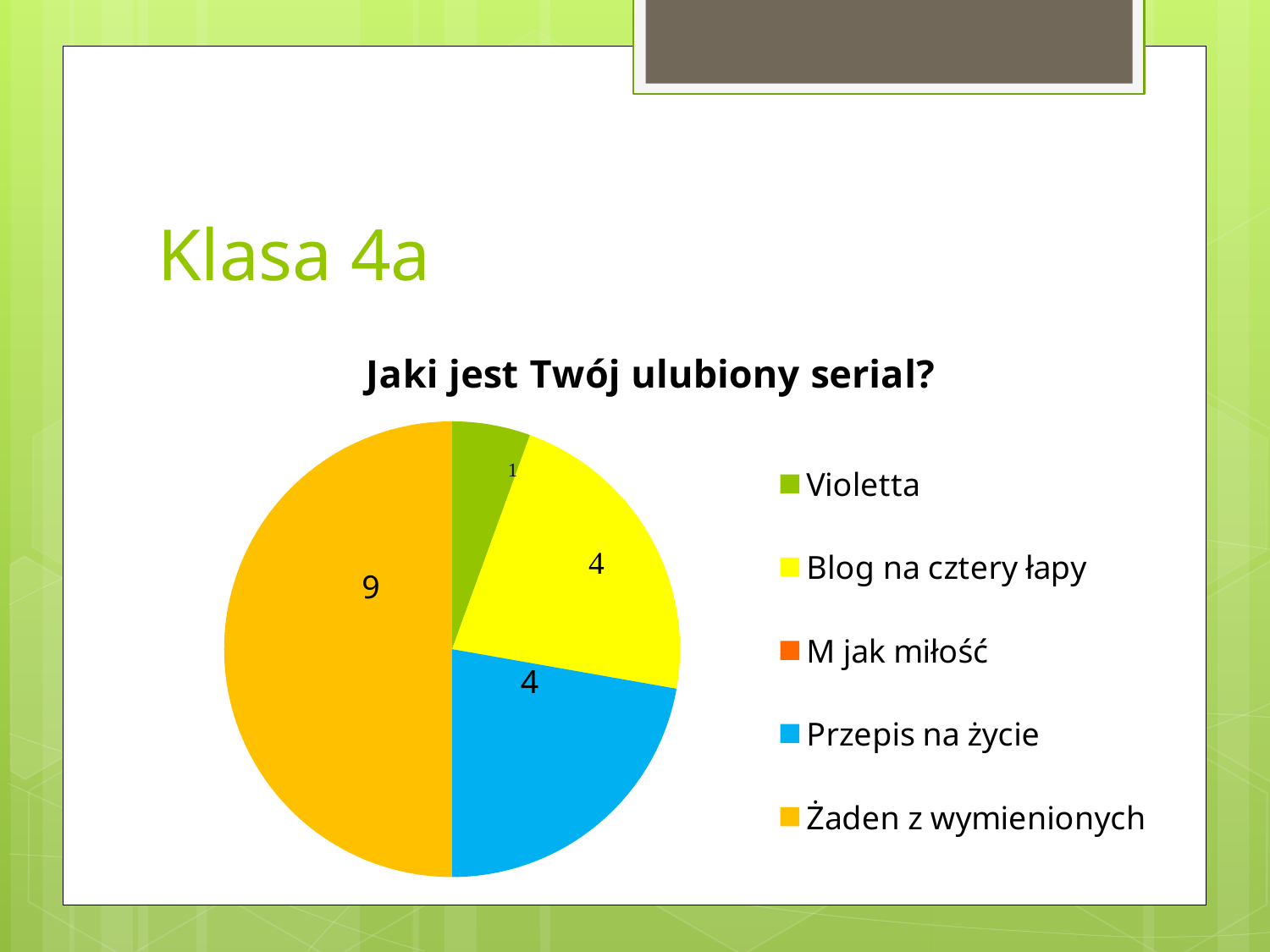
What is the value for Violetta? 1 Which category has the largest slice of the pie? Żaden z wymienionych What is the value for Przepis na życie? 4 What is the value for Blog na cztery łapy? 4 What colour is the slice for Przepis na życie? blue How many pupils chose Żaden z wymienionych? 9 Which is larger, the value for Żaden z wymienionych or the value for Przepis na życie? Żaden z wymienionych How many categories does the legend list? 5 What is the difference between the values for Żaden z wymienionych and Violetta? 8 What type of chart is shown on the slide? pie chart What is the title of the chart? Jaki jest Twój ulubiony serial? What is the difference between the values for Blog na cztery łapy and Violetta? 3